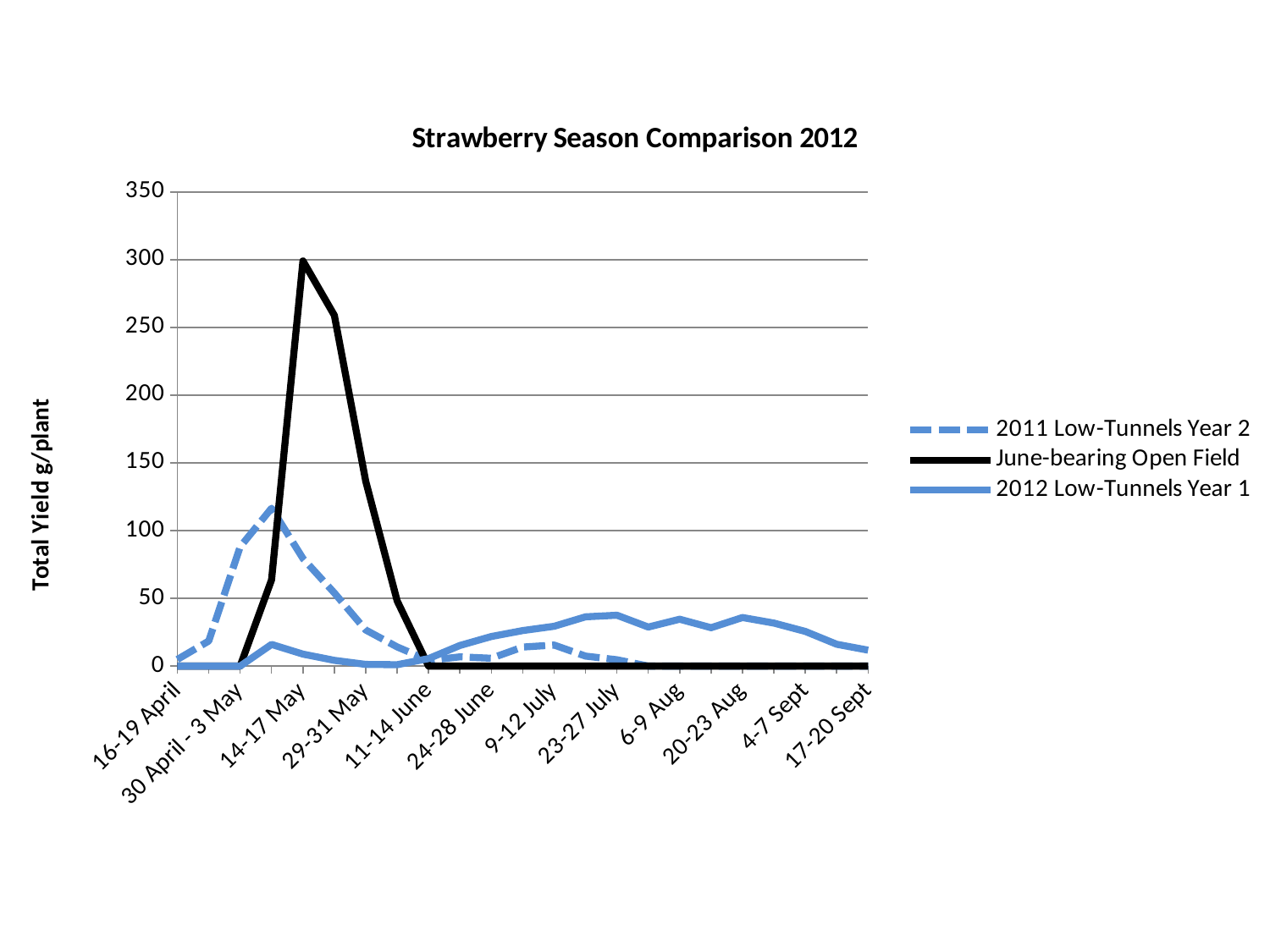
Is the value for June-bearing Open Field at 14-17 May greater or less than 250? greater At 6-9 Aug, which series has the higher value: 2012 Low-Tunnels Year 1 or June-bearing Open Field? 2012 Low-Tunnels Year 1 Which series reaches the highest peak value on the chart? June-bearing Open Field Is the value for 2012 Low-Tunnels Year 1 at 23-27 July greater or less than 50? less What is the label on the vertical axis? Total Yield g/plant How many series does the legend list? 3 At 14-17 May, which series has the higher value: June-bearing Open Field or 2012 Low-Tunnels Year 1? June-bearing Open Field How many date labels are shown along the x axis? 12 What is the title of the chart? Strawberry Season Comparison 2012 What kind of chart is shown on the slide? line chart Is the value for 2011 Low-Tunnels Year 2 at 14-17 May greater or less than 100? less Does the June-bearing Open Field line rise or fall from 14-17 May to 11-14 June? fall